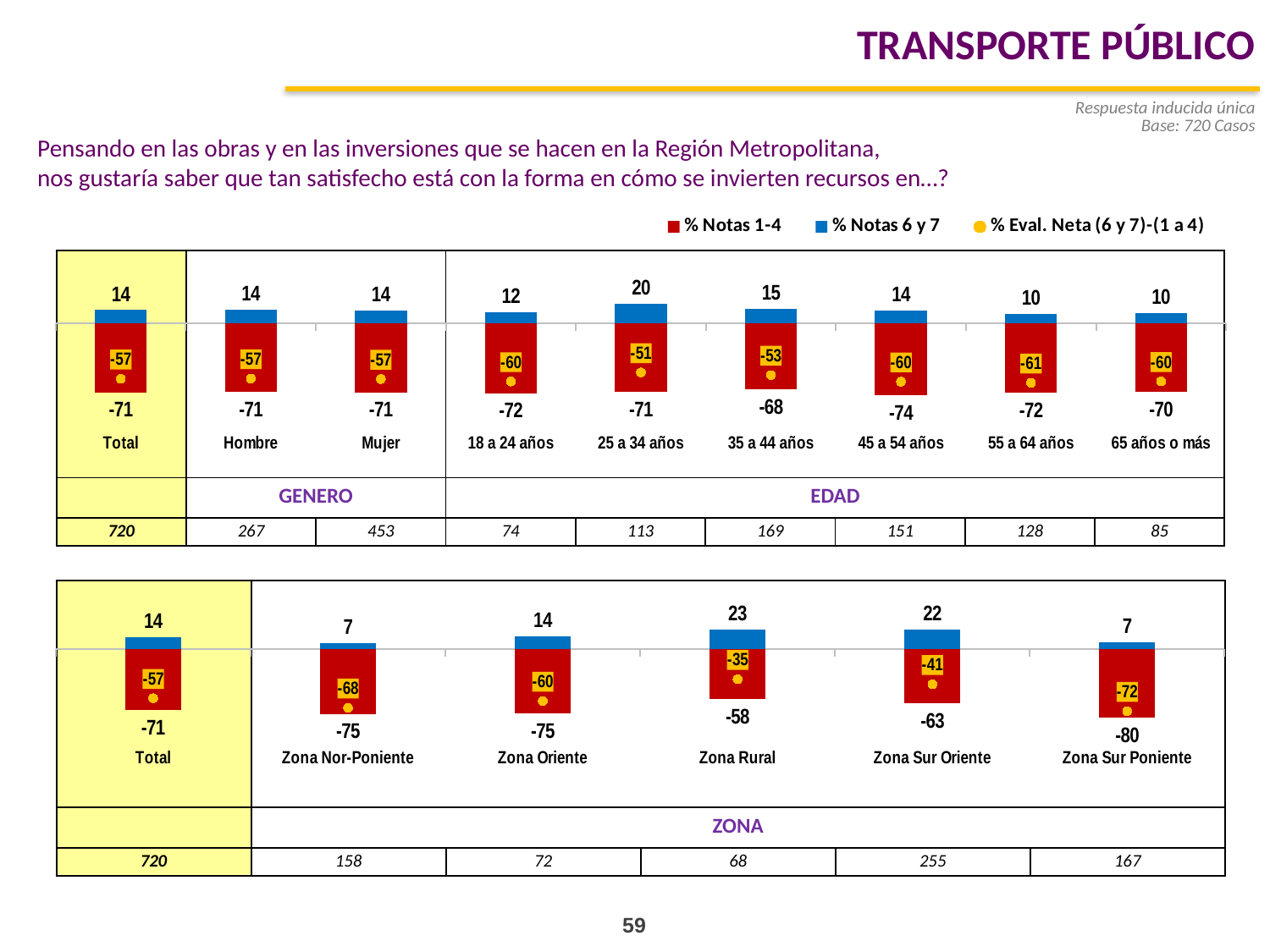
In the bottom chart, what is the % Notas 1-4 value for Zona Sur Poniente? -80 In the top chart, what is the % Notas 1-4 value for 45 a 54 años? -74 In the top chart, what is the % Notas 6 y 7 value for 25 a 34 años? 20 In the bottom chart, which has a higher % Notas 6 y 7 value, Zona Sur Oriente or Zona Nor-Poniente? Zona Sur Oriente How many zone categories (excluding Total) are shown in the bottom chart? 5 In the bottom chart, what is the difference between the % Notas 6 y 7 values for Zona Rural and Zona Oriente? 9 How many series does the legend list? 3 In the top chart, which age group has the highest % Notas 6 y 7 value? 25 a 34 años What kind of chart is the top chart? Combination bar and line chart (bars with a point-marker series) In the top chart, what is the % Eval. Neta value for 55 a 64 años? -61 In the bottom chart, what is the % Notas 6 y 7 value for Zona Rural? 23 In the bottom chart, which zone has the lowest % Eval. Neta value? Zona Sur Poniente